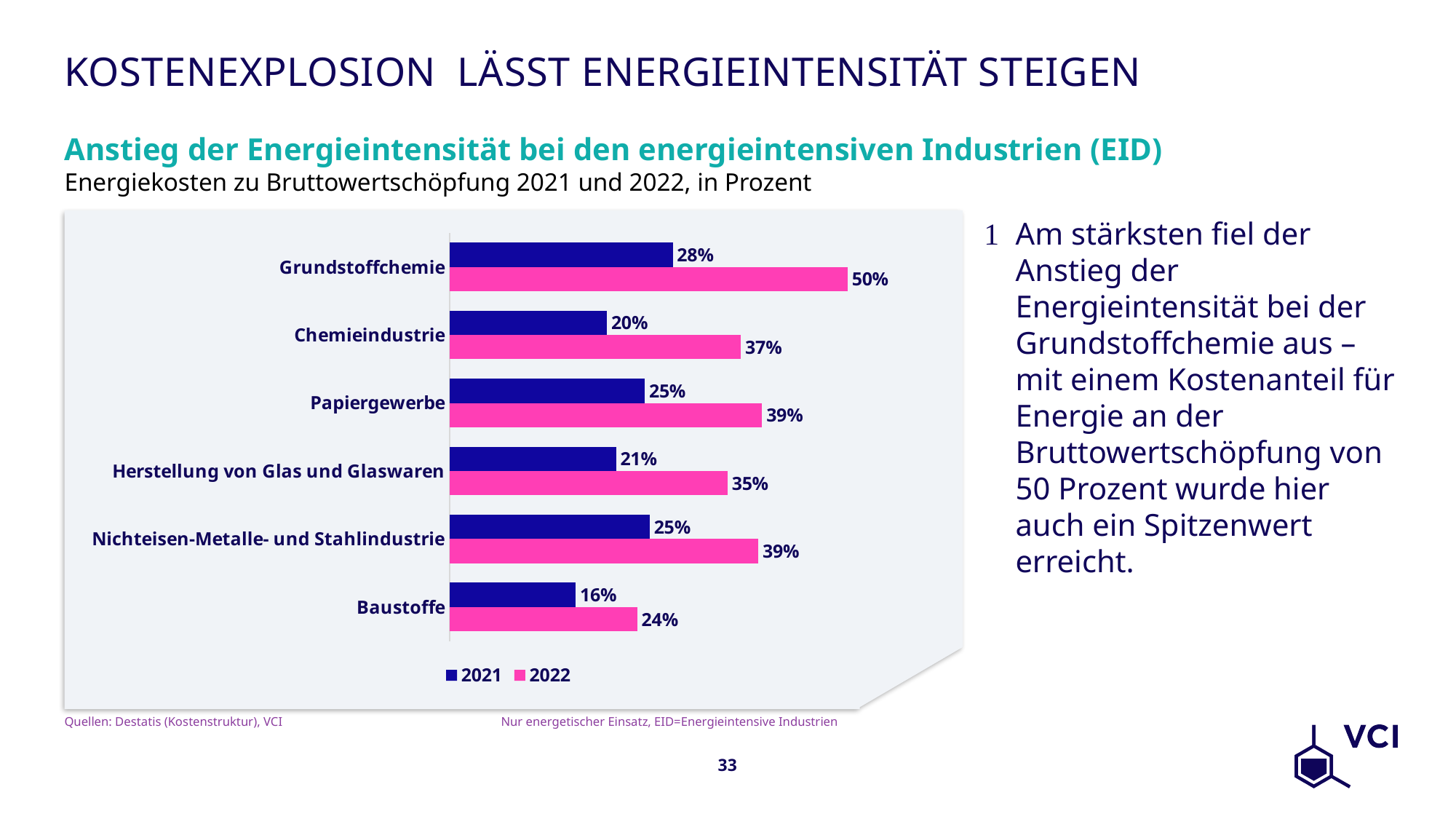
What is the 2021 value for Herstellung von Glas und Glaswaren? 21% How many series does the legend list? 2 What kind of chart is shown on the slide? Bar chart What is the 2022 value for Grundstoffchemie? 50% Which series is shown in pink? 2022 Which category has the lowest 2021 value? Baustoffe Which category has the highest 2022 value? Grundstoffchemie How many categories are shown in the chart? 6 What is the 2021 value for Baustoffe? 16% Which is larger: the 2022 value for Papiergewerbe or the 2022 value for Herstellung von Glas und Glaswaren? Papiergewerbe What is the title of the chart? Anstieg der Energieintensität bei den energieintensiven Industrien (EID) What is the difference between the 2022 and 2021 values for Chemieindustrie? 17 percentage points